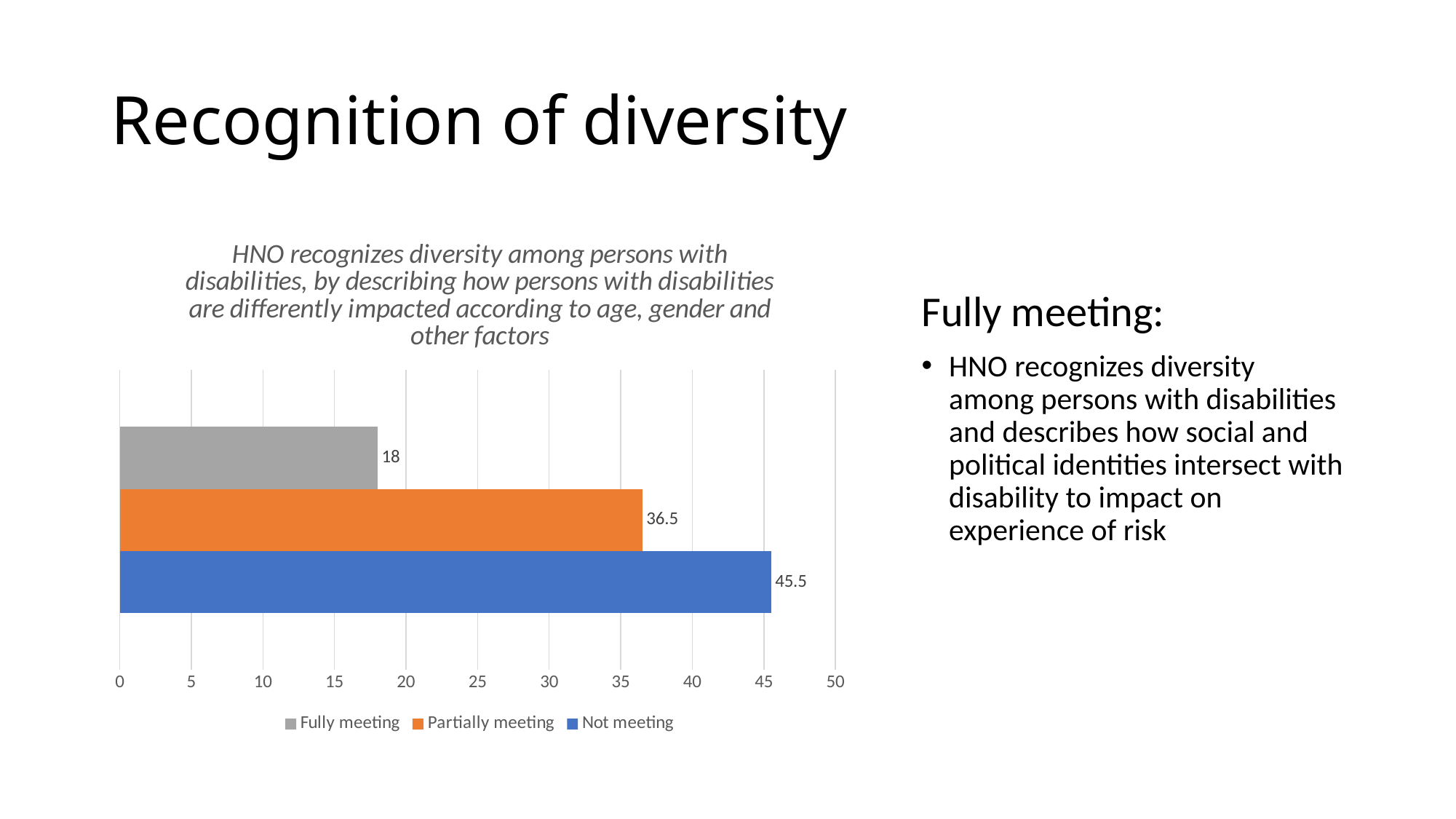
Is the value for Not meeting greater or less than 40? greater Which series has the highest value? Not meeting How many series does the legend list? 3 What is the value for Partially meeting? 36.5 What is the value for Fully meeting? 18 What is the difference between the Partially meeting and Fully meeting values? 18.5 What colour is the bar for Partially meeting? orange Which series has the lowest value? Fully meeting Which is larger, the value for Fully meeting or the value for Partially meeting? Partially meeting What is the difference between the Not meeting and Partially meeting values? 9 What is the value for Not meeting? 45.5 What kind of chart is shown on the slide? bar chart